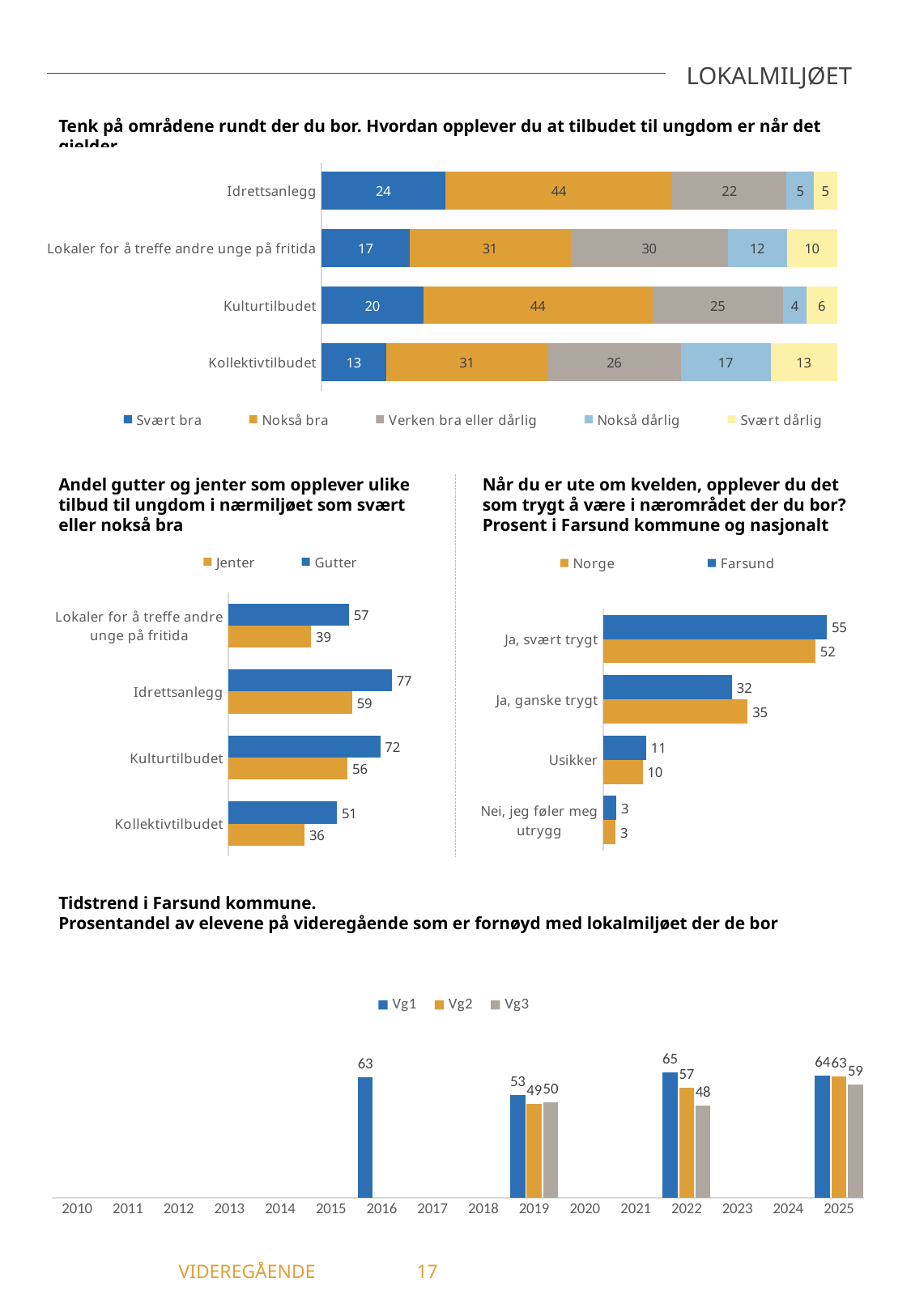
In the bottom chart 'Tidstrend i Farsund kommune', what is the value for Vg3 in 2022? 48 What kind of chart is the bottom chart 'Tidstrend i Farsund kommune'? Bar chart In the chart 'Andel gutter og jenter som opplever ulike tilbud til ungdom i nærmiljøet som svært eller nokså bra', what is the difference between Gutter and Jenter for Kollektivtilbudet? 15 In the chart 'Når du er ute om kvelden, opplever du det som trygt å være i nærområdet der du bor?', how many categories are shown? 4 In the top stacked bar chart (Tenk på områdene rundt der du bor), how many series does the legend list? 5 In the chart 'Når du er ute om kvelden, opplever du det som trygt å være i nærområdet der du bor?', what is the value for Farsund for 'Ja, svært trygt'? 55 In the top stacked bar chart (Tenk på områdene rundt der du bor), which category has the highest 'Svært dårlig' value? Kollektivtilbudet In the top stacked bar chart (Tenk på områdene rundt der du bor), what is the total of the Kollektivtilbudet bar? 100 In the chart 'Andel gutter og jenter som opplever ulike tilbud til ungdom i nærmiljøet som svært eller nokså bra', which category has the lowest Jenter value? Kollektivtilbudet In the chart 'Når du er ute om kvelden, opplever du det som trygt å være i nærområdet der du bor?', which is larger for 'Ja, ganske trygt': Norge or Farsund? Norge In the top stacked bar chart (Tenk på områdene rundt der du bor), what is the value for 'Svært bra' for Idrettsanlegg? 24 In the chart 'Andel gutter og jenter som opplever ulike tilbud til ungdom i nærmiljøet som svært eller nokså bra', what is the value for Jenter for Idrettsanlegg? 59